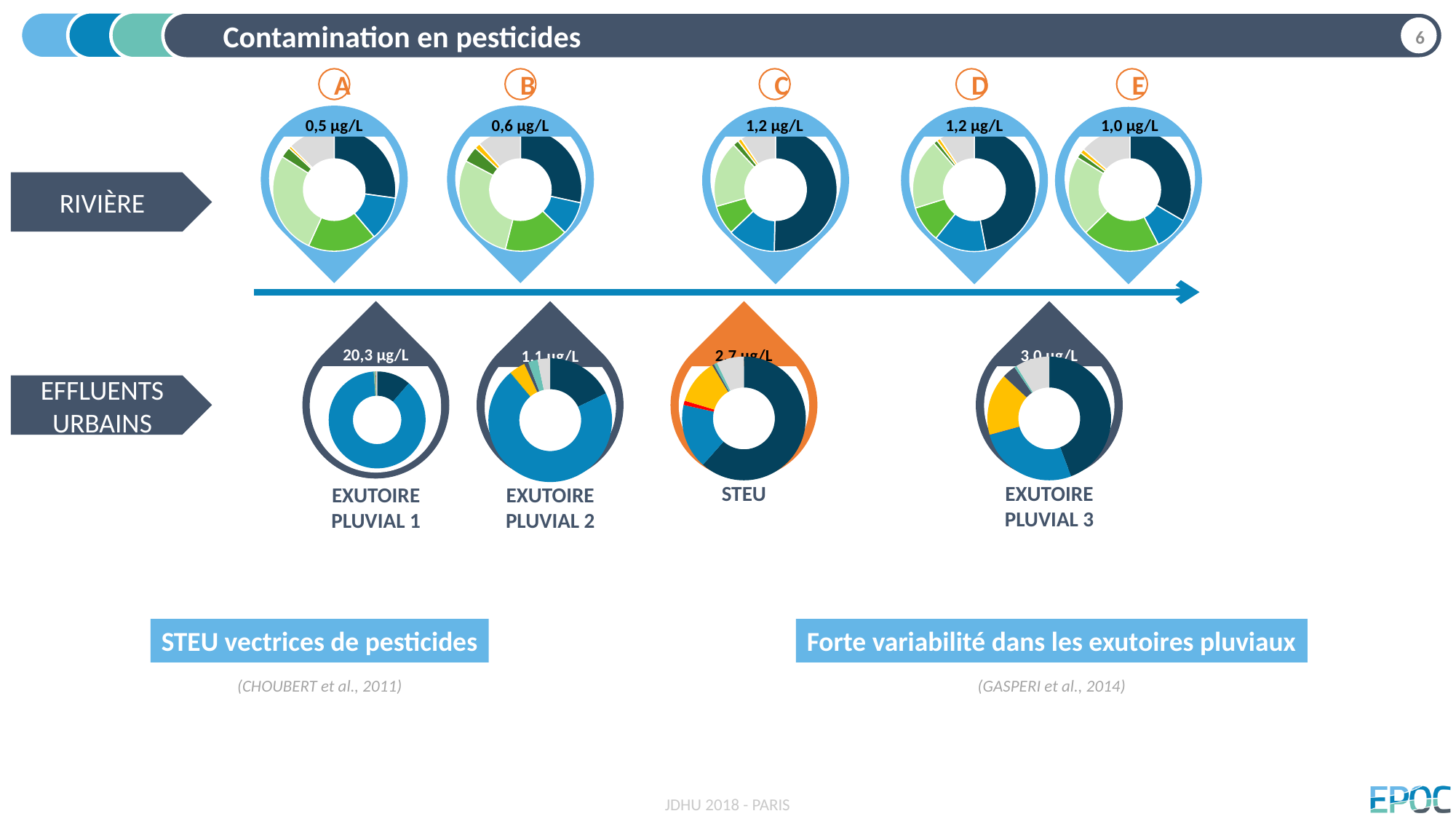
How many river sites (RIVIÈRE row) are shown with donut charts? 5 What pesticide concentration is shown for EXUTOIRE PLUVIAL 3? 3,0 µg/L Which has a higher pesticide concentration, STEU or EXUTOIRE PLUVIAL 3? EXUTOIRE PLUVIAL 3 What total pesticide concentration is shown for river site E? 1,0 µg/L What pesticide concentration is shown for EXUTOIRE PLUVIAL 1? 20,3 µg/L What total pesticide concentration is shown for river site A? 0,5 µg/L What is the difference in pesticide concentration between river site B and river site A? 0,1 µg/L What pesticide concentration is shown for STEU? 2,7 µg/L What kind of chart is used to show the composition at each site? Donut (pie) chart Among the river sites A to E, which site has the lowest pesticide concentration? A Among the urban effluent charts, which one has the highest pesticide concentration? EXUTOIRE PLUVIAL 1 Among the urban effluent charts, which one has the lowest pesticide concentration? EXUTOIRE PLUVIAL 2